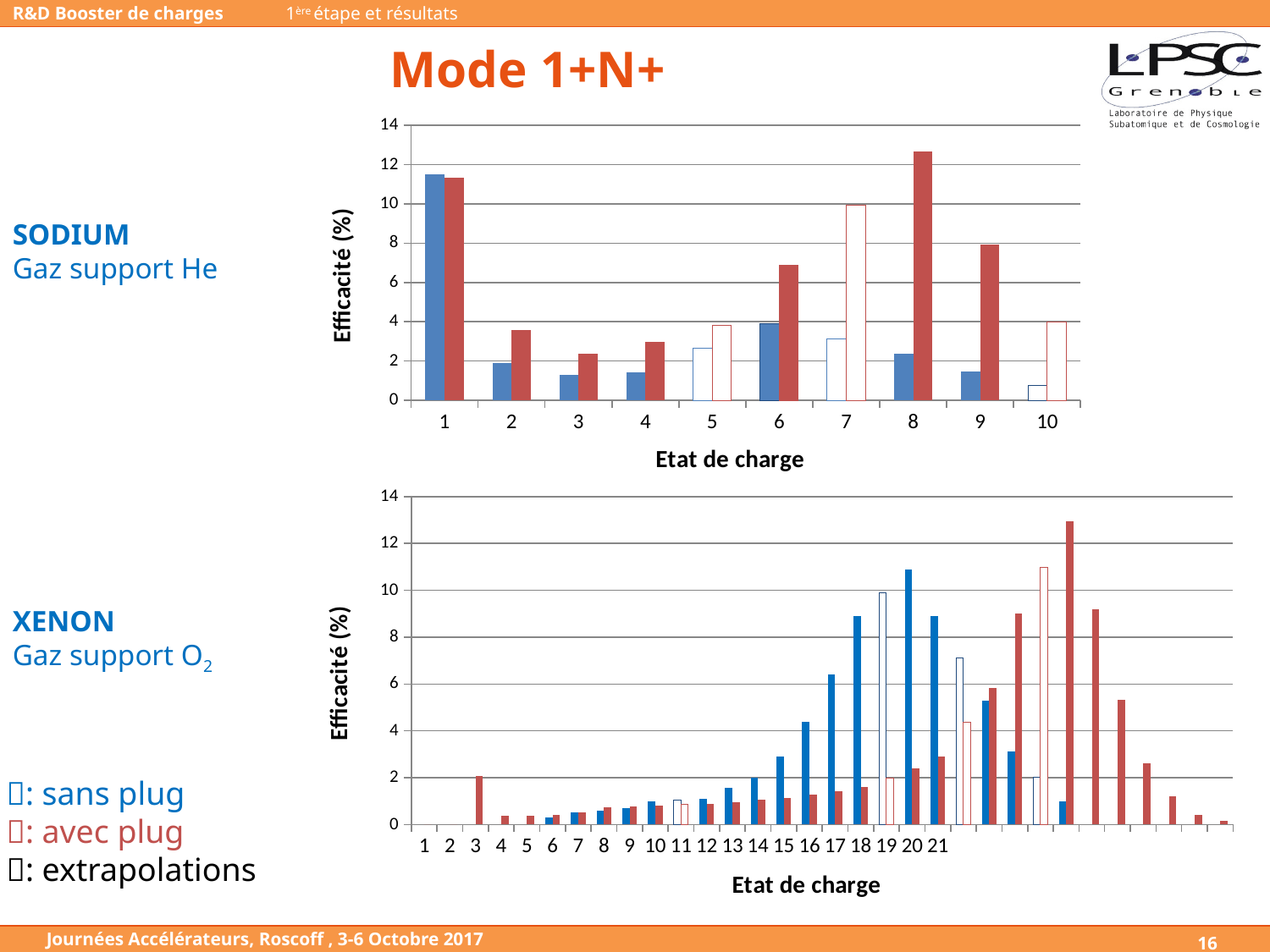
What type of chart is the top chart (SODIUM, Gaz support He)? bar chart In the bottom chart (XENON), at charge state 20, which is larger: the blue (sans plug) bar or the red (avec plug) bar? blue (sans plug) What is the y-axis title of the two charts? Efficacité (%) In the top chart (SODIUM), at which charge state is the blue (sans plug) bar highest? 1 In the top chart (SODIUM), how many charge states (Etat de charge) are shown on the x axis? 10 In the top chart (SODIUM), is the blue (sans plug) value at charge state 3 greater or less than 2? less In the bottom chart (XENON), is the blue (sans plug) value at charge state 17 greater or less than 6? greater In the top chart (SODIUM), at charge state 6, which is larger: the blue (sans plug) bar or the red (avec plug) bar? red (avec plug) In the bottom chart (XENON), is the blue (sans plug) value at charge state 20 greater or less than 10? greater In the bottom chart (XENON), at which labelled charge state is the blue (sans plug) bar highest? 20 In the top chart (SODIUM), at which charge state is the red (avec plug) bar highest? 8